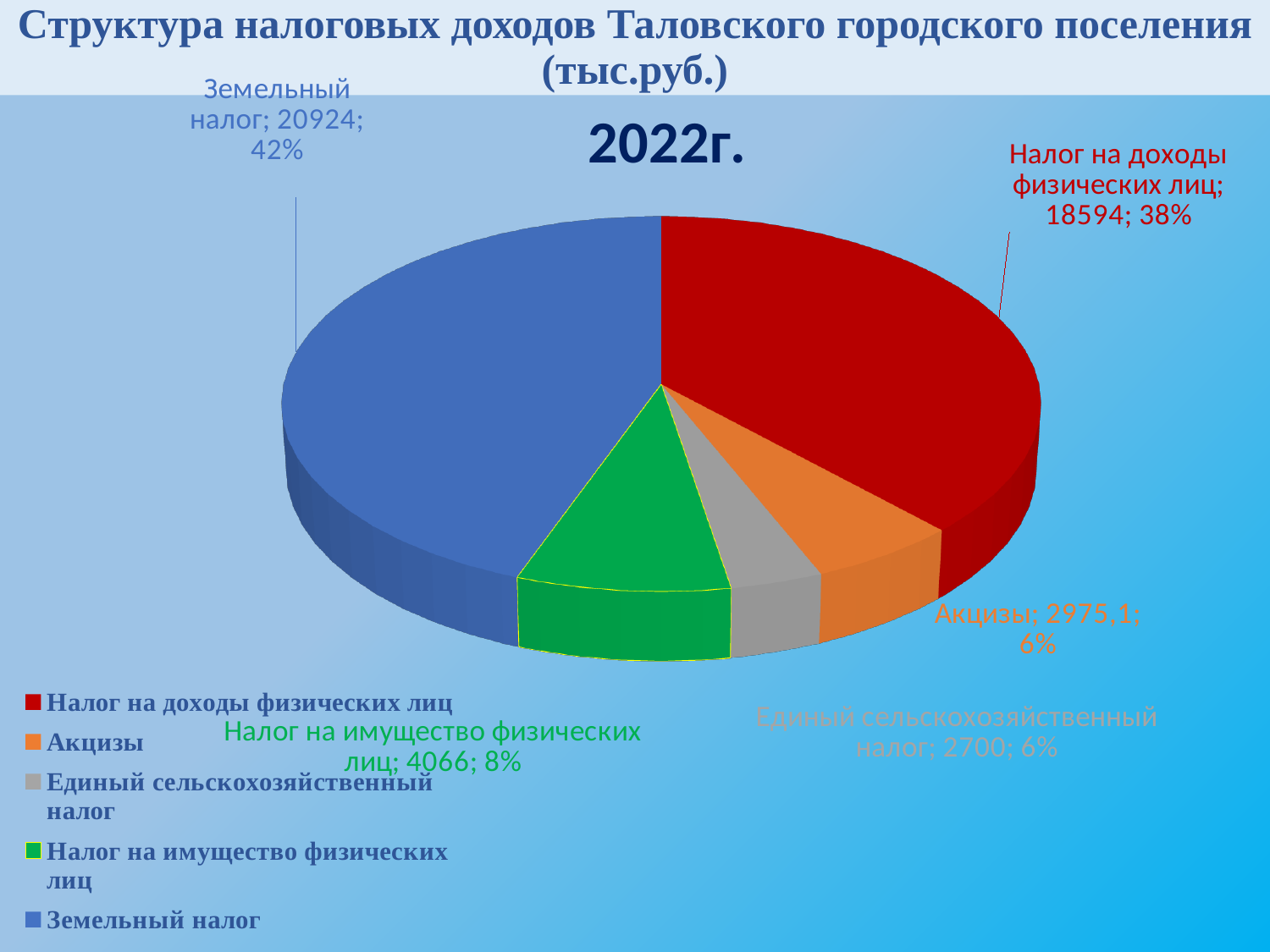
What share of the pie does Налог на имущество физических лиц represent? 8% Which category has the smallest slice of the pie? Единый сельскохозяйственный налог How many entries does the legend list? 5 What is the value for Налог на доходы физических лиц? 18594 What is the value for Акцизы? 2975,1 What kind of chart is shown on the slide? Pie chart What share of the pie does Земельный налог represent? 42% Which is larger: Налог на имущество физических лиц or Акцизы? Налог на имущество физических лиц What is the value for Земельный налог? 20924 What is the value for Налог на имущество физических лиц? 4066 What is the difference between the values for Земельный налог and Налог на доходы физических лиц? 2330 Which category has the largest slice of the pie? Земельный налог